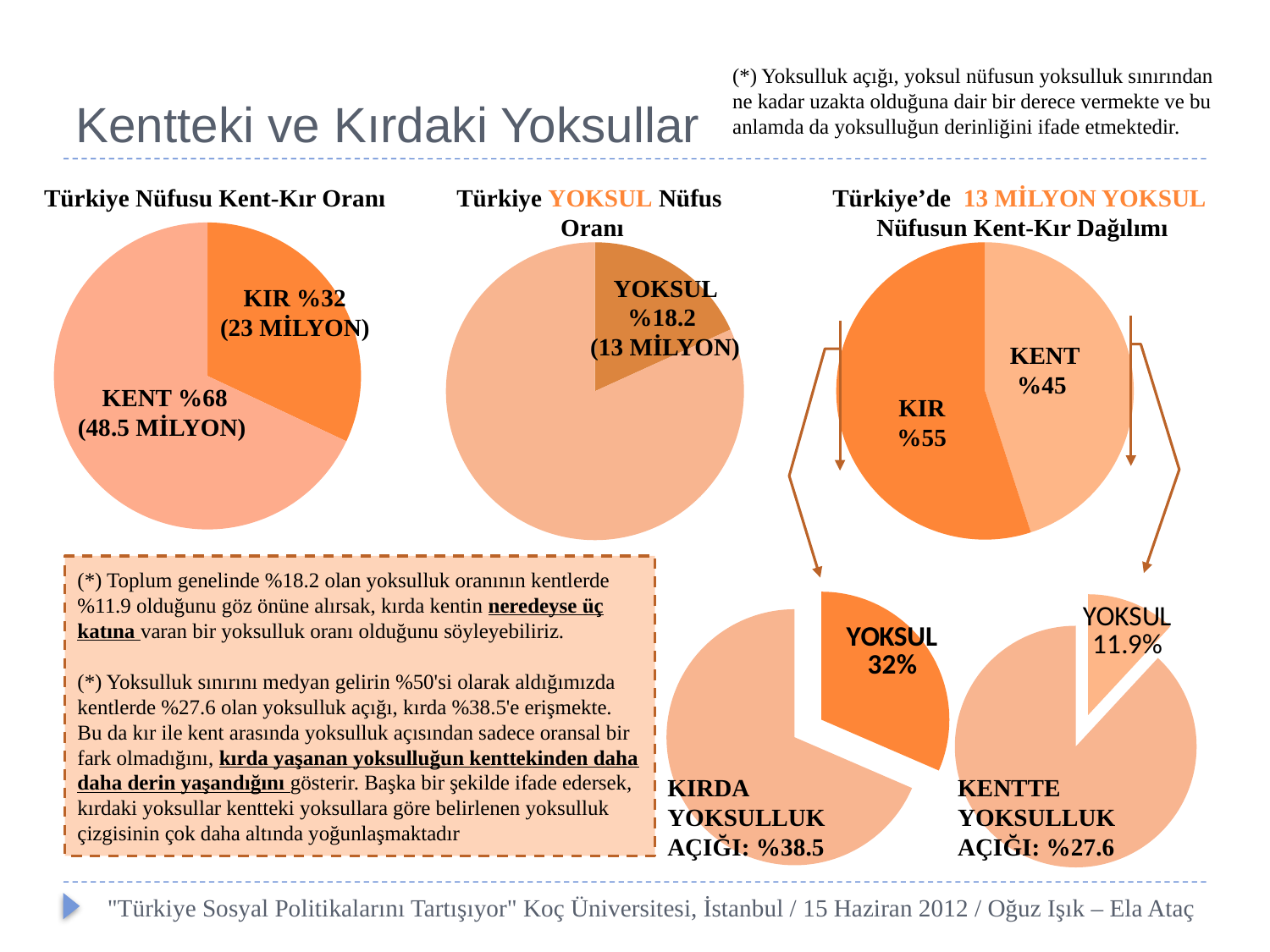
How many pie charts are shown on the slide? 5 In the chart titled "Türkiye YOKSUL Nüfus Oranı", what percentage is the YOKSUL slice? %18.2 In the chart titled "Türkiye Nüfusu Kent-Kır Oranı", what share of the population is labelled KENT? %68 In the bottom-right pie chart labelled "KENTTE YOKSULLUK AÇIĞI", what percentage is the YOKSUL slice? 11.9% In the chart titled "Türkiye Nüfusu Kent-Kır Oranı", how many million people does the KIR slice represent? 23 MİLYON In the chart titled "Türkiye YOKSUL Nüfus Oranı", how many million people does the YOKSUL slice represent? 13 MİLYON In the chart titled "Türkiye Nüfusu Kent-Kır Oranı", which slice is larger, KENT or KIR? KENT What kind of chart is used for "Türkiye Nüfusu Kent-Kır Oranı"? Pie chart In the chart titled "Türkiye'de 13 MİLYON YOKSUL Nüfusun Kent-Kır Dağılımı", which slice is larger, KIR or KENT? KIR In the chart titled "Türkiye'de 13 MİLYON YOKSUL Nüfusun Kent-Kır Dağılımı", what is the difference in percentage points between the KIR and KENT slices? 10